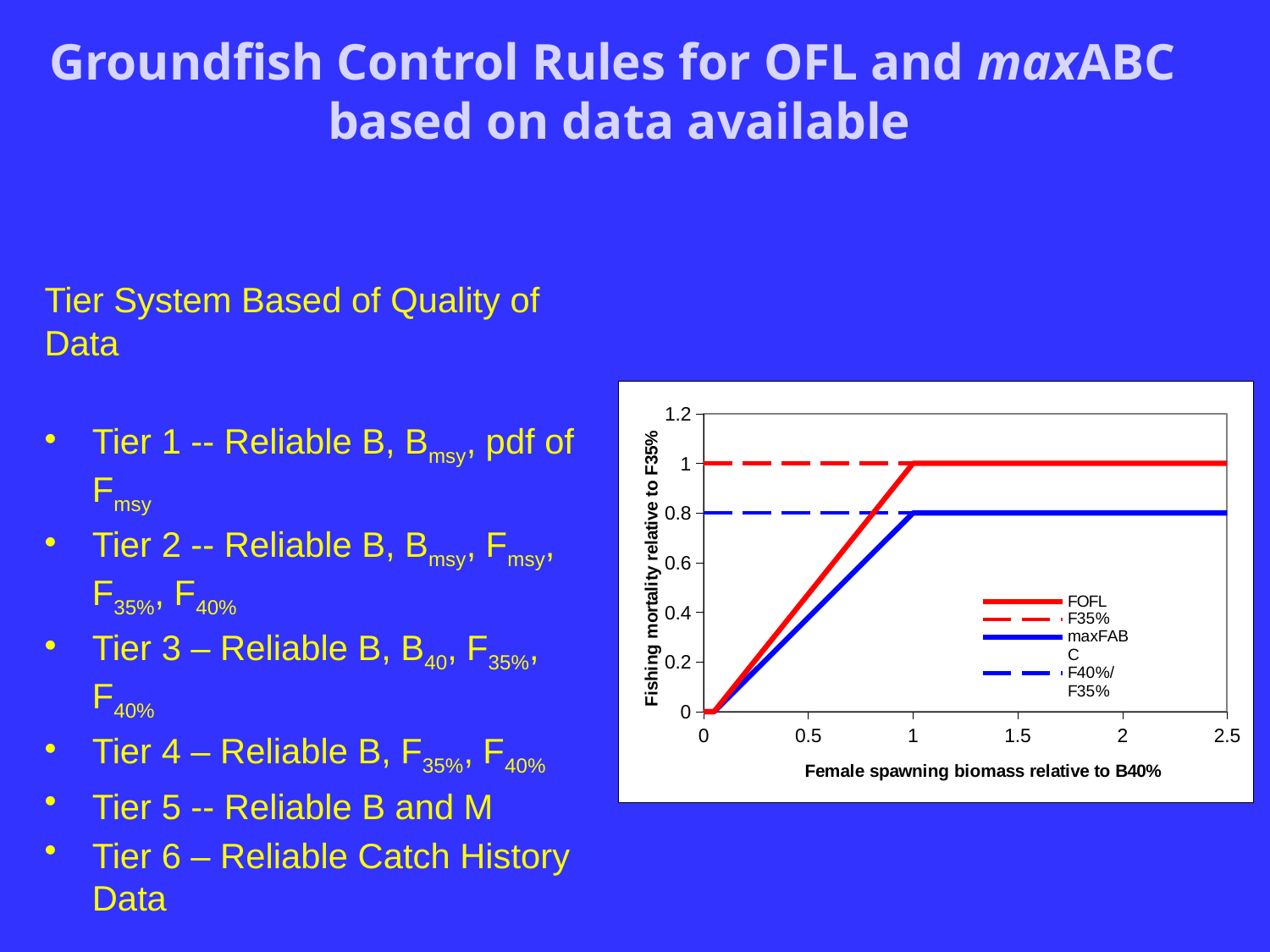
What kind of chart is shown on the slide? line chart How many series does the chart legend list? 4 At a female spawning biomass of 2, what is the difference between the FOFL value and the maxFABC value? 0.2 Which series has the lowest value at a female spawning biomass of 0.5? maxFABC Is the value of the maxFABC line at a female spawning biomass of 0.5 greater or less than 0.6? less What is the value of the maxFABC line at a female spawning biomass of 2? 0.8 At a female spawning biomass of 1.5, which is larger, FOFL or maxFABC? FOFL What is the value of the FOFL line at a female spawning biomass of 2? 1 Is the value of the FOFL line at a female spawning biomass of 0.5 greater or less than 0.8? less What is the title of the chart's x axis? Female spawning biomass relative to B40% What is the title of the chart's y axis? Fishing mortality relative to F35% Does the FOFL line rise or fall as female spawning biomass increases from 0 to 1? rises